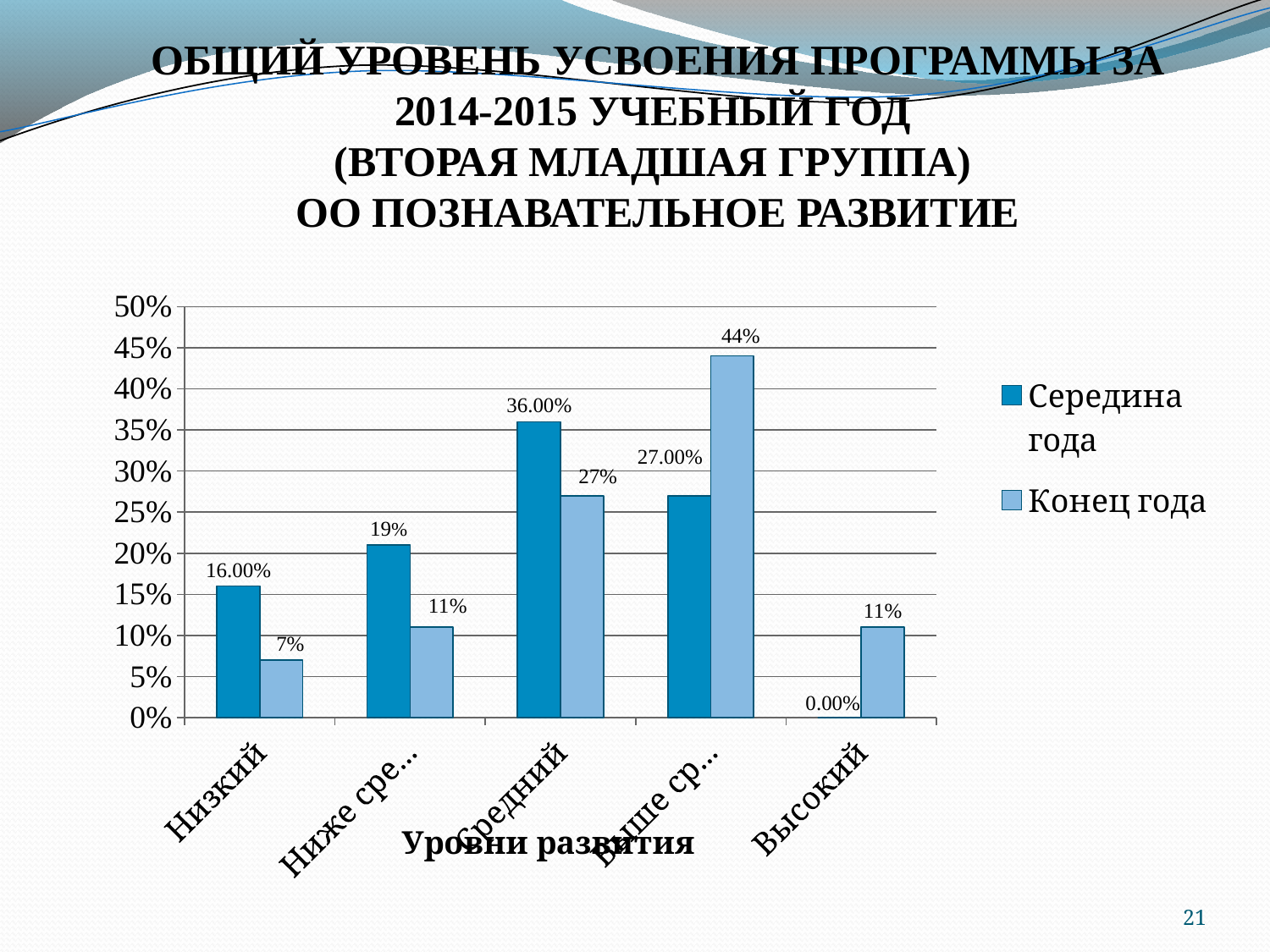
What is the value for Конец года in the Высокий category? 11% What is the value for Середина года in the Средний category? 36.00% What is the highest value in the Конец года series? 44% Which category has the lowest value for Середина года? Высокий How many series does the legend list? 2 What is the value for Конец года in the Низкий category? 7% In the Низкий category, which series has the larger value, Середина года or Конец года? Середина года What is the value for Середина года in the Высокий category? 0.00% What is the value for Конец года in the Средний category? 27% What is the value for Середина года in the Низкий category? 16.00% What kind of chart is shown on the slide? Bar chart How many categories are shown on the x axis? 5